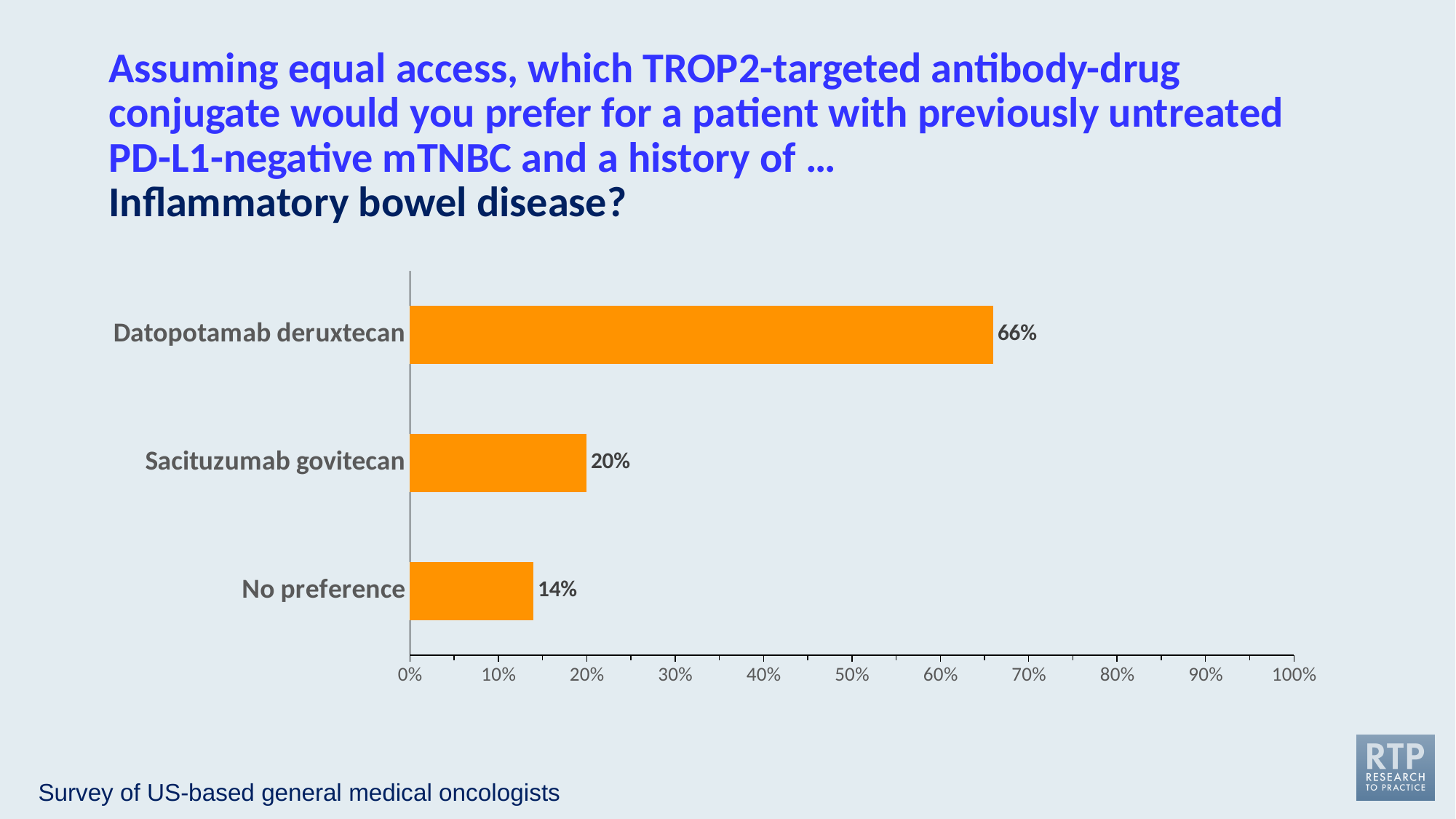
Which received a larger share of responses, sacituzumab govitecan or no preference? Sacituzumab govitecan Is the value for datopotamab deruxtecan greater or less than 50%? greater What is the difference in percentage points between sacituzumab govitecan and no preference? 6 What percentage of respondents preferred sacituzumab govitecan? 20% Which option received the lowest percentage of responses? No preference What percentage of respondents preferred datopotamab deruxtecan? 66% What is the maximum value shown on the horizontal axis? 100% What percentage of respondents had no preference? 14% How many response options are shown in the chart? 3 Which option received the highest percentage of responses? Datopotamab deruxtecan What is the difference in percentage points between datopotamab deruxtecan and sacituzumab govitecan? 46 What type of chart is shown on the slide? Bar chart